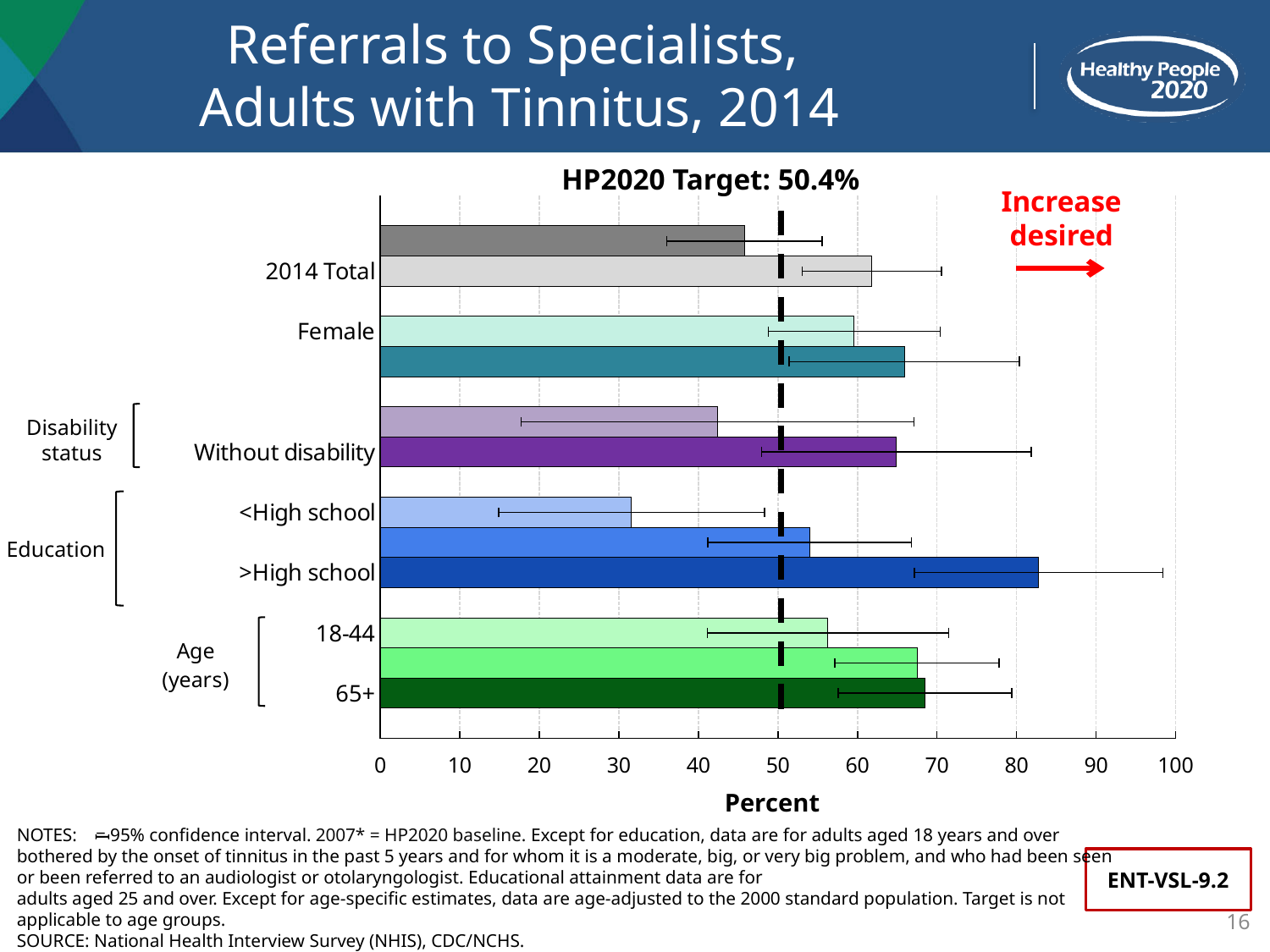
Is the value for Without disability greater or less than 60? greater What kind of chart is shown on the slide? bar chart Is the value for <High school greater or less than 40? less Which labeled category has the shortest bar in the chart? <High school What is the HP2020 Target value shown above the chart? 50.4% Is the value for 18-44 greater or less than 50? greater What is the title of the horizontal axis? Percent Which labeled category has the longest bar in the chart? >High school Which has the larger value, >High school or <High school? >High school Which has the larger value, Female or 65+? 65+